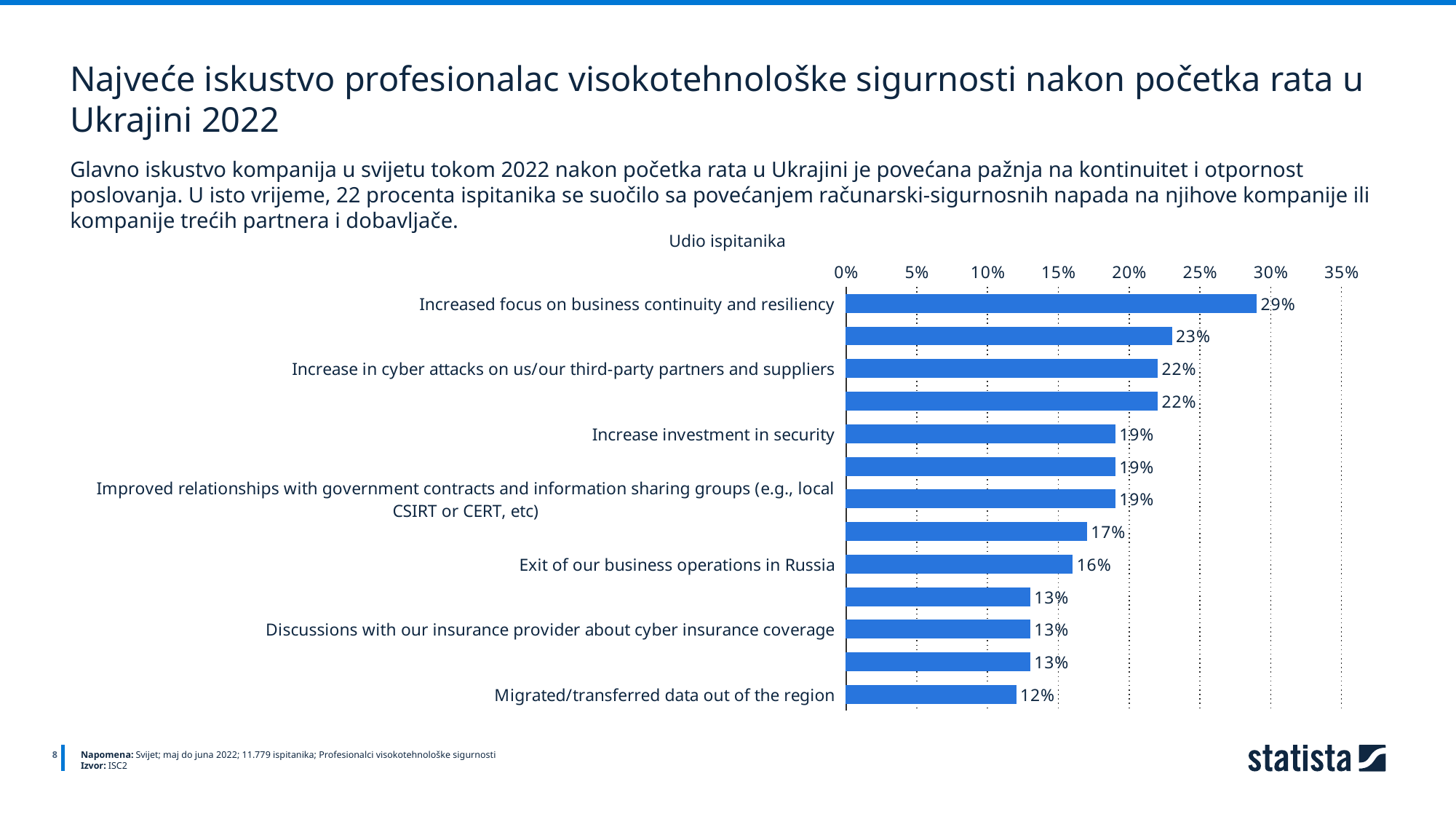
What kind of chart is shown on the slide? Bar chart What is the value for 'Increased focus on business continuity and resiliency'? 29% What is the value for 'Discussions with our insurance provider about cyber insurance coverage'? 13% What is the value for 'Migrated/transferred data out of the region'? 12% How many bars are plotted in the chart? 13 Which is larger: 'Exit of our business operations in Russia' or 'Increase investment in security'? Increase investment in security What is the axis title shown above the chart? Udio ispitanika What is the difference between 'Increased focus on business continuity and resiliency' and 'Increase investment in security'? 10% Which category has the lowest value? Migrated/transferred data out of the region What is the value for 'Exit of our business operations in Russia'? 16% What is the value for 'Increase in cyber attacks on us/our third-party partners and suppliers'? 22% Which category has the highest value? Increased focus on business continuity and resiliency